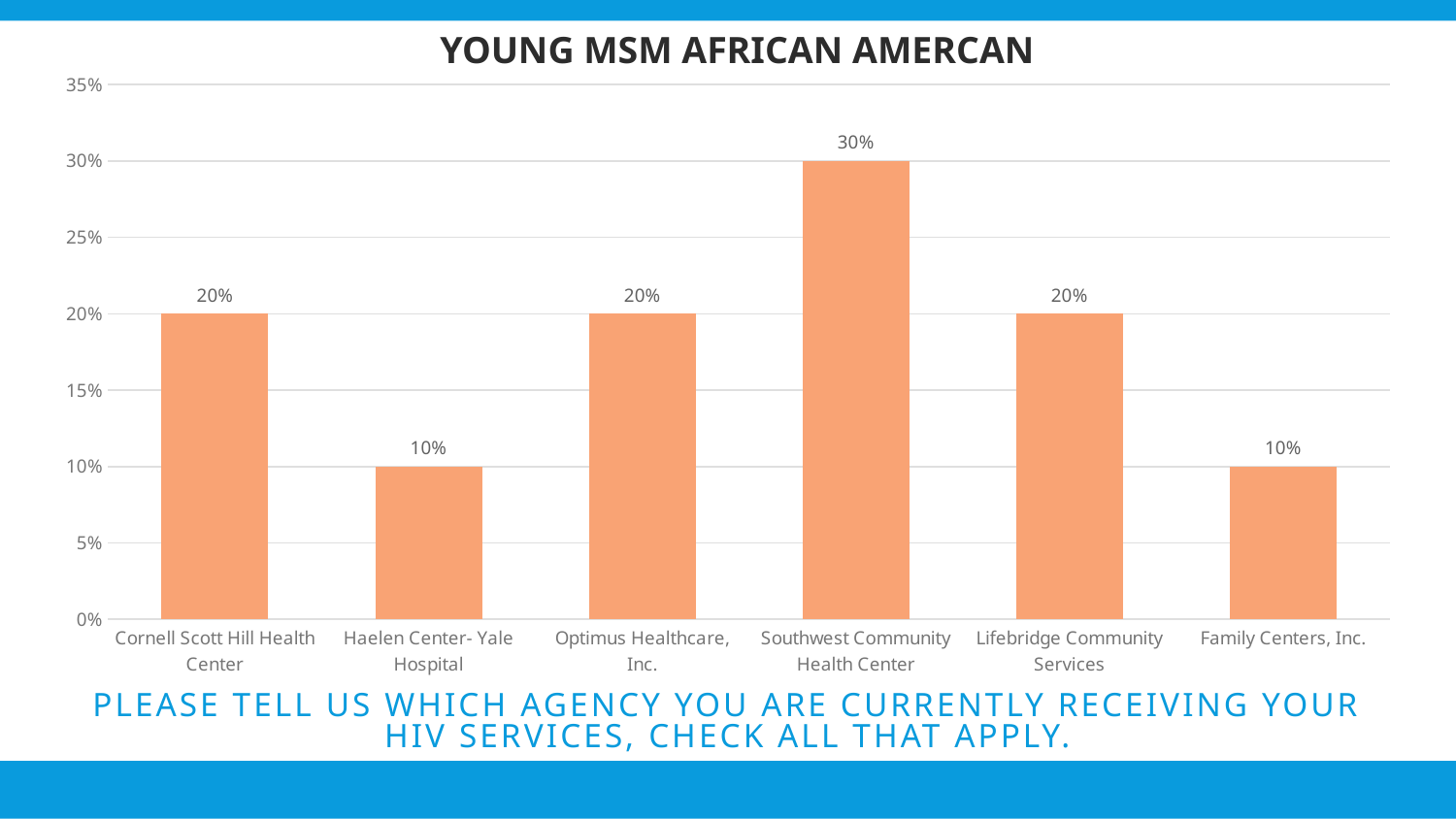
Which is larger, the value for Optimus Healthcare, Inc. or the value for Family Centers, Inc.? Optimus Healthcare, Inc. What is the difference between the values for Southwest Community Health Center and Cornell Scott Hill Health Center? 10% Is the value for Southwest Community Health Center greater or less than 25%? greater What is the value for Haelen Center- Yale Hospital? 10% What is the value for Family Centers, Inc.? 10% What is the value for Lifebridge Community Services? 20% What kind of chart is shown on the slide? bar chart What is the title of the chart? YOUNG MSM AFRICAN AMERCAN What is the value for Southwest Community Health Center? 30% What is the difference between the values for Lifebridge Community Services and Haelen Center- Yale Hospital? 10% How many agencies are shown on the x axis? 6 Which agency has the highest value? Southwest Community Health Center